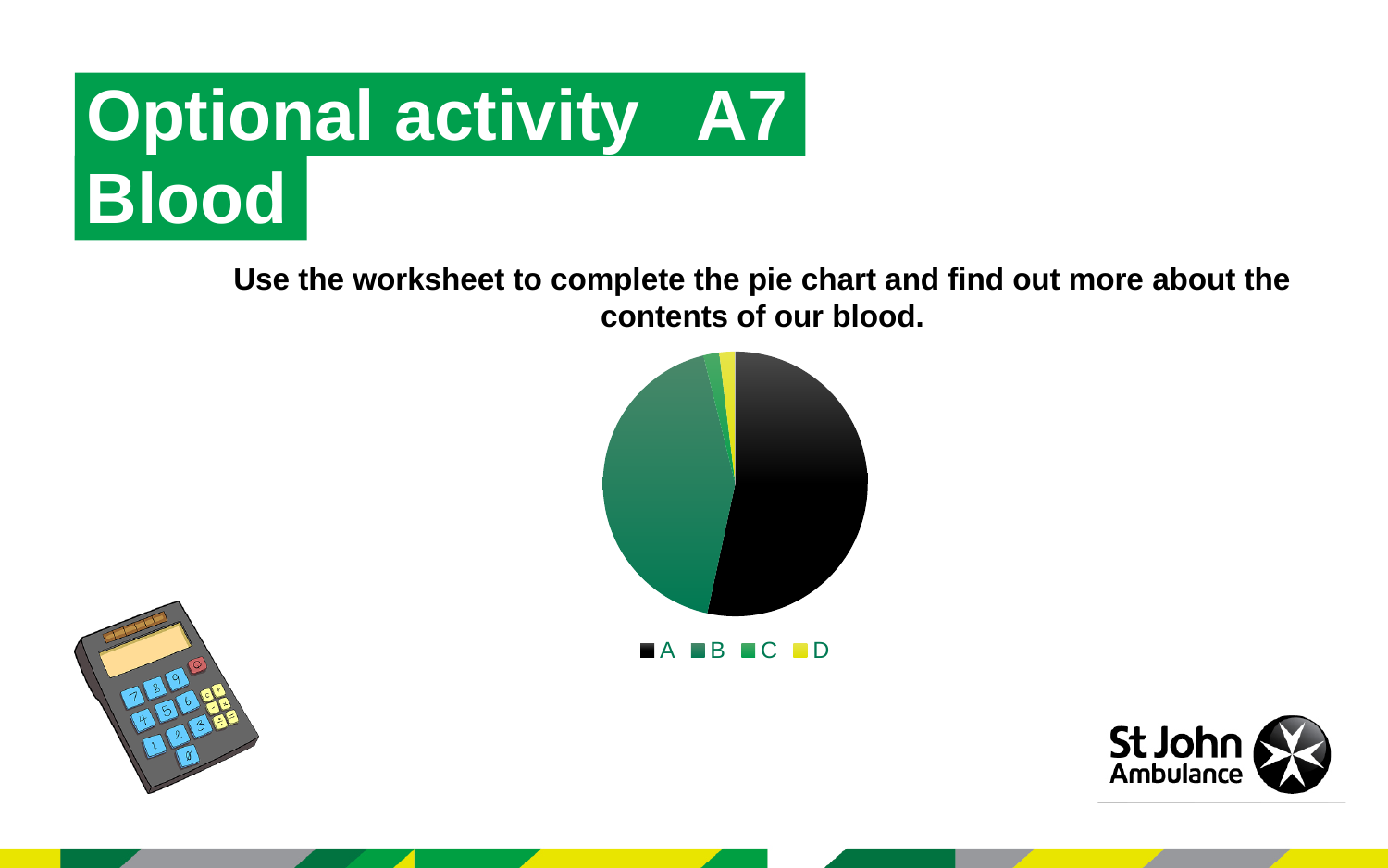
Which slice is larger in the pie chart, A or B? A Which slice is larger in the pie chart, B or C? B Which slice is larger in the pie chart, A or D? A How many slices does the pie chart have? 4 Which category has the largest slice in the pie chart? A What are the legend entries of the pie chart? A, B, C, D What colour is slice A in the pie chart? black What kind of chart is shown on the slide? pie chart How many entries does the legend of the pie chart list? 4